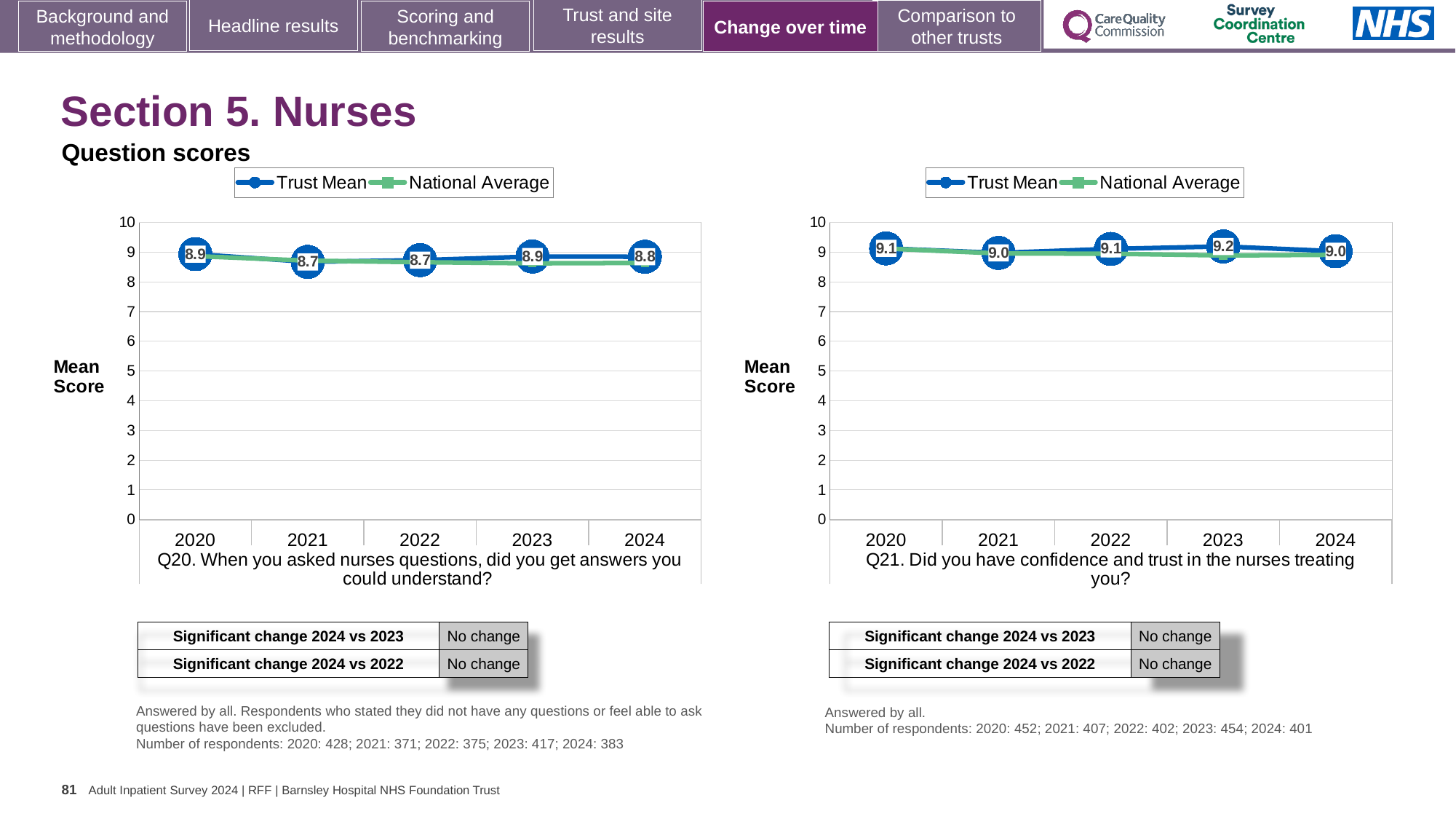
What type of chart is the Q21 chart on the right? Line chart In the Q21 chart on the right, which year has the highest Trust Mean score? 2023 In the Q21 chart on the right, what is the difference between the Trust Mean scores for 2023 and 2024? 0.2 In the Q20 chart on the left, what is the Trust Mean score for 2020? 8.9 In the Q20 chart on the left, which year has the larger Trust Mean score, 2020 or 2021? 2020 How many years are shown on the x axis of the Q21 chart on the right? 5 In the Q20 chart on the left, what is the Trust Mean score for 2024? 8.8 In the Q20 chart on the left, is the National Average value for 2024 greater or less than 8? greater In the Q21 chart on the right, does the Trust Mean score rise or fall from 2021 to 2023? Rise In the Q21 chart on the right, what is the Trust Mean score for 2021? 9.0 In the Q21 chart on the right, what is the Trust Mean score for 2023? 9.2 How many series does the legend of the Q20 chart on the left list? 2